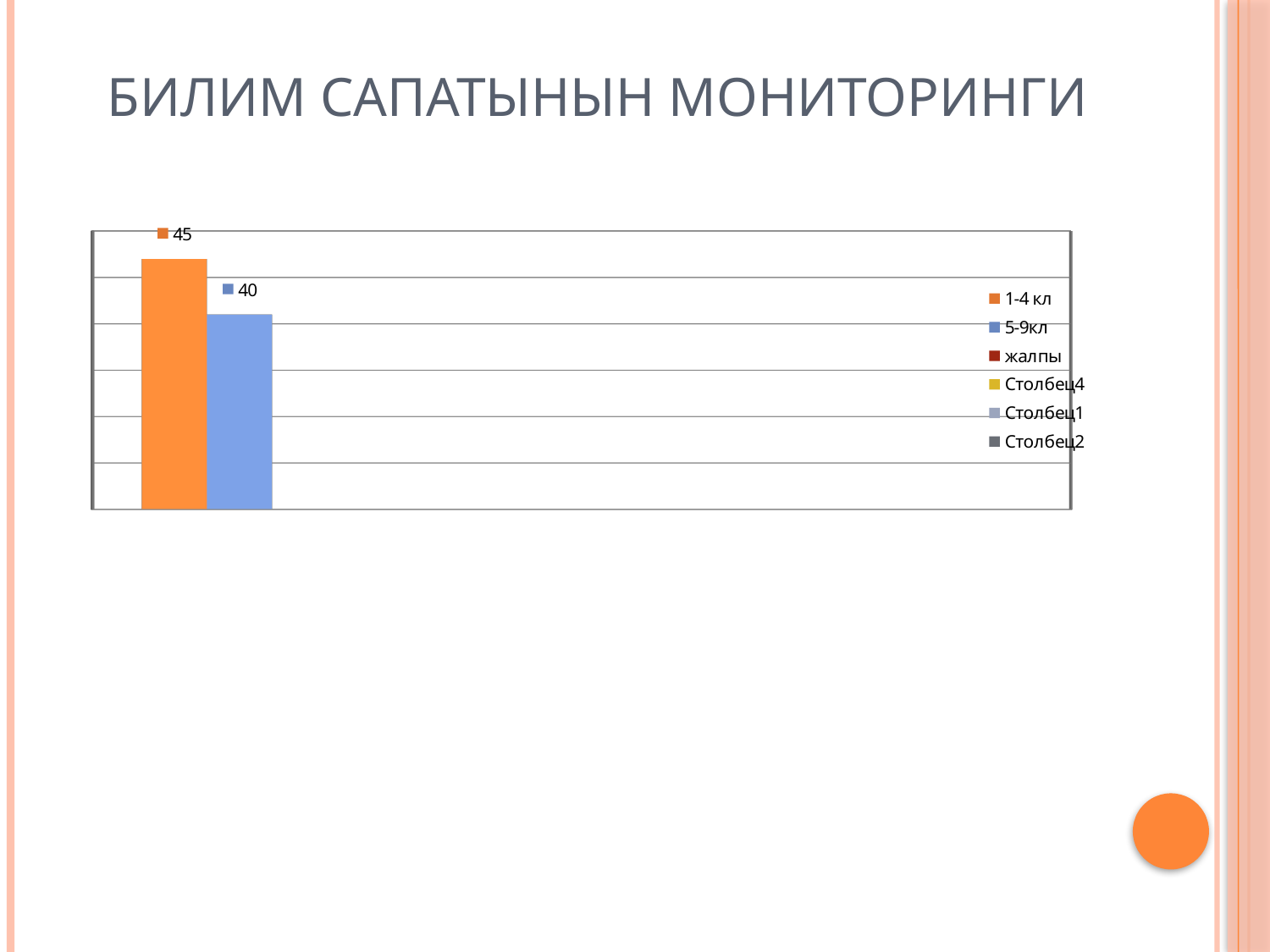
What is the value for the 5-9кл series? 40 What kind of chart is shown on the slide? bar chart Which series has the highest value shown on the chart? 1-4 кл How many series does the legend list? 6 Which is larger, the value for 1-4 кл or the value for 5-9кл? 1-4 кл How many bars are plotted on the chart? 2 What is the value for the 1-4 кл series? 45 Which of the two plotted series has the lower value? 5-9кл What is the title of the slide containing the chart? БИЛИМ САПАТЫНЫН МОНИТОРИНГИ What is the difference between the values for 1-4 кл and 5-9кл? 5 What colour is the bar for the 1-4 кл series? orange